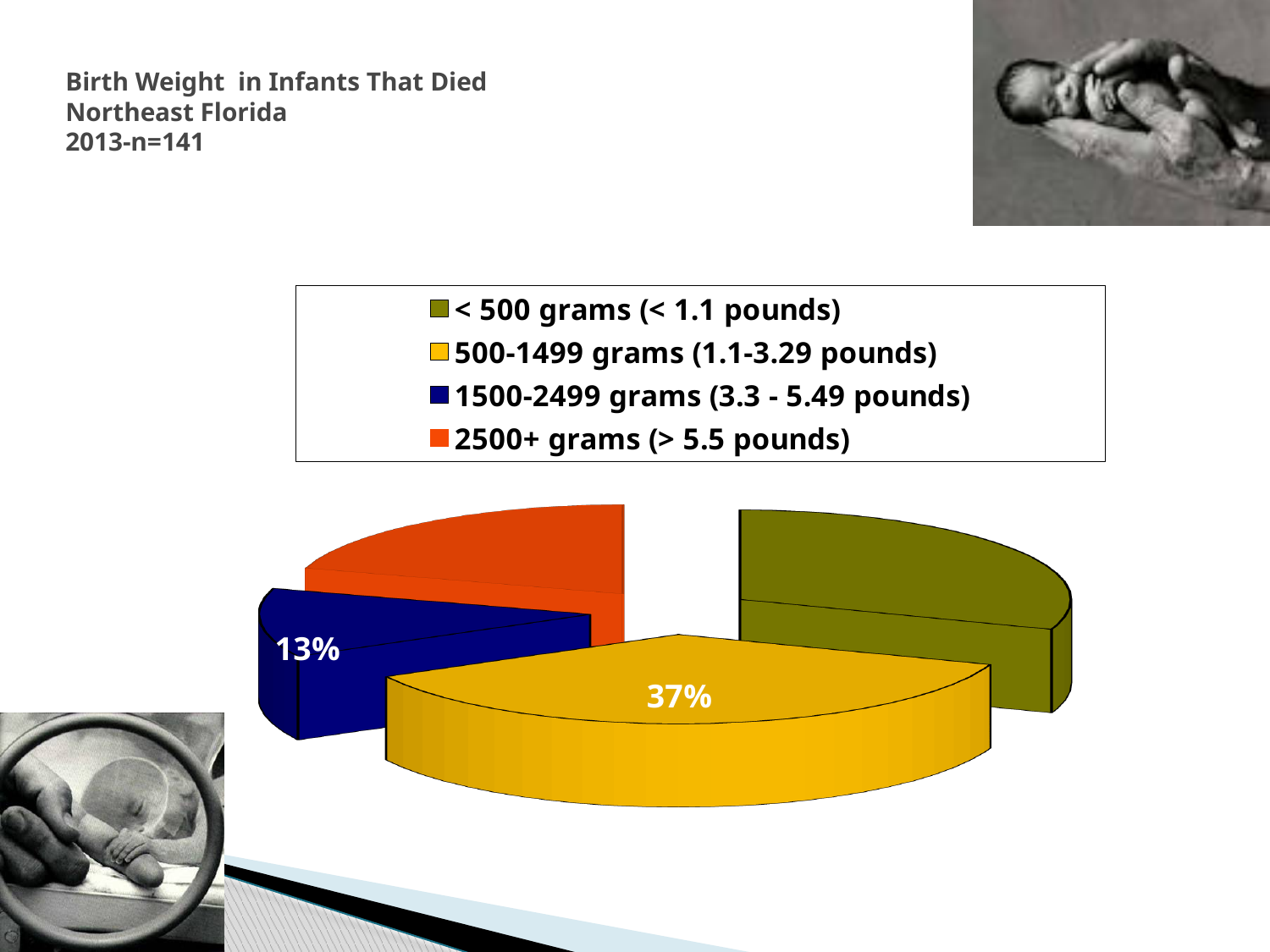
Which is larger: the share for 500-1499 grams or the share for 1500-2499 grams? 500-1499 grams Which is larger: the share for 2500+ grams or the share for 1500-2499 grams? 2500+ grams What percentage of the pie does the 1500-2499 grams (3.3 - 5.49 pounds) slice represent? 13% What is the title of the chart on the slide? Birth Weight in Infants That Died Northeast Florida 2013-n=141 Which colour represents the 2500+ grams (> 5.5 pounds) category in the legend? Orange Which birth weight category has the largest share of the pie? 500-1499 grams (1.1-3.29 pounds) What kind of chart is shown on the slide? Pie chart How many categories does the legend list? 4 How many slices does the pie chart have? 4 Which birth weight category has the smallest share of the pie? 1500-2499 grams (3.3 - 5.49 pounds) What percentage of the pie does the 500-1499 grams (1.1-3.29 pounds) slice represent? 37% What is the difference in percentage points between the 500-1499 grams slice and the 1500-2499 grams slice? 24 percentage points